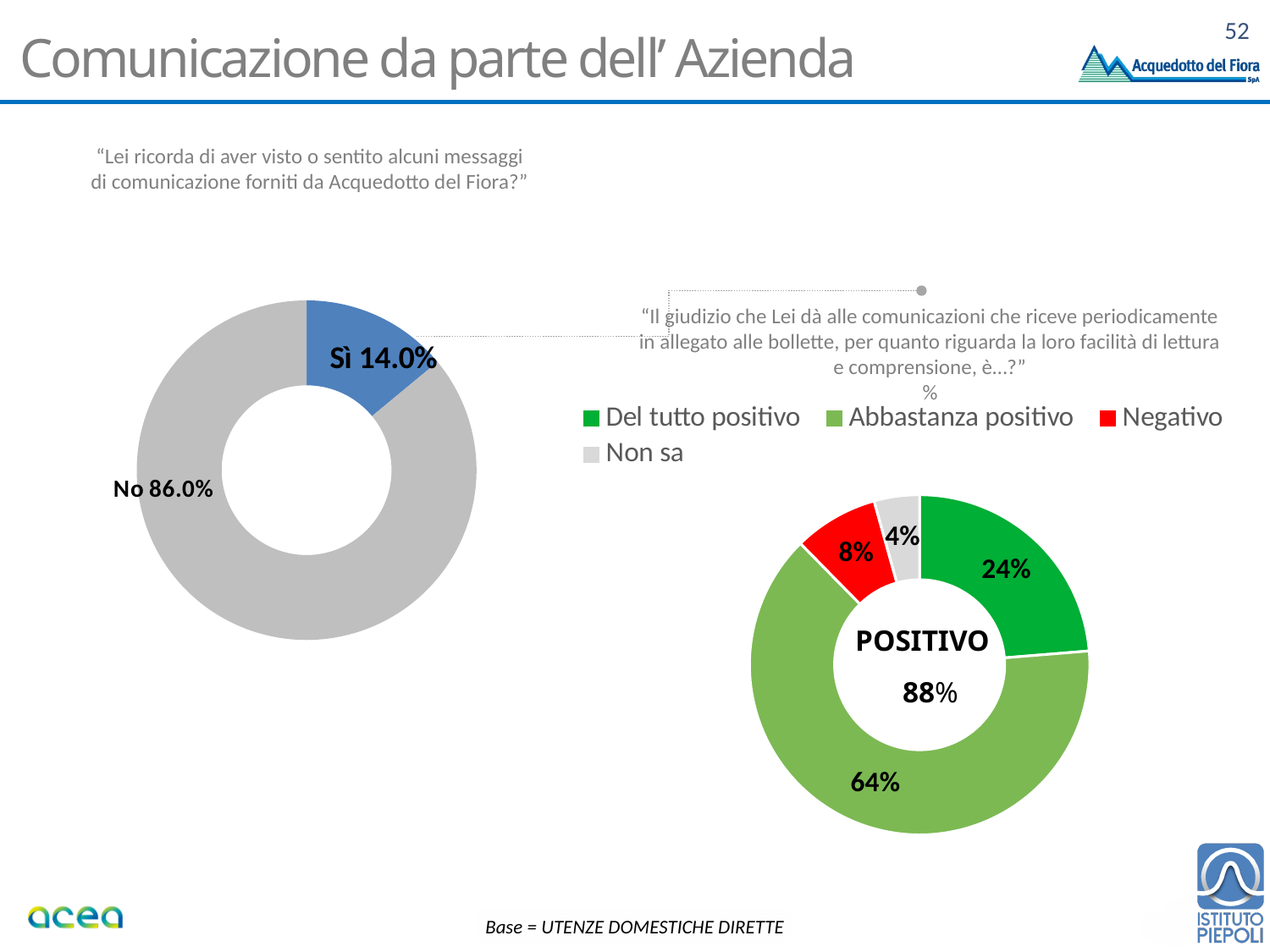
How many entries does the legend of the right chart list? 4 On the right chart, what percentage is shown for "Abbastanza positivo"? 64% What kind of chart is the left chart? Doughnut chart On the left chart, which answer has the larger share, "Sì" or "No"? No On the right chart, what is the combined share of "Del tutto positivo" and "Abbastanza positivo"? 88% On the right chart, what percentage is shown for "Del tutto positivo"? 24% On the right chart, what percentage is shown for "Negativo"? 8% On the left chart, what is the difference between the "No" share and the "Sì" share? 72.0% On the right chart, which category has the largest share? Abbastanza positivo On the left chart, what percentage of respondents answered "Sì"? 14.0% On the left chart, what percentage of respondents answered "No"? 86.0% On the right chart, which category has the smallest share? Non sa